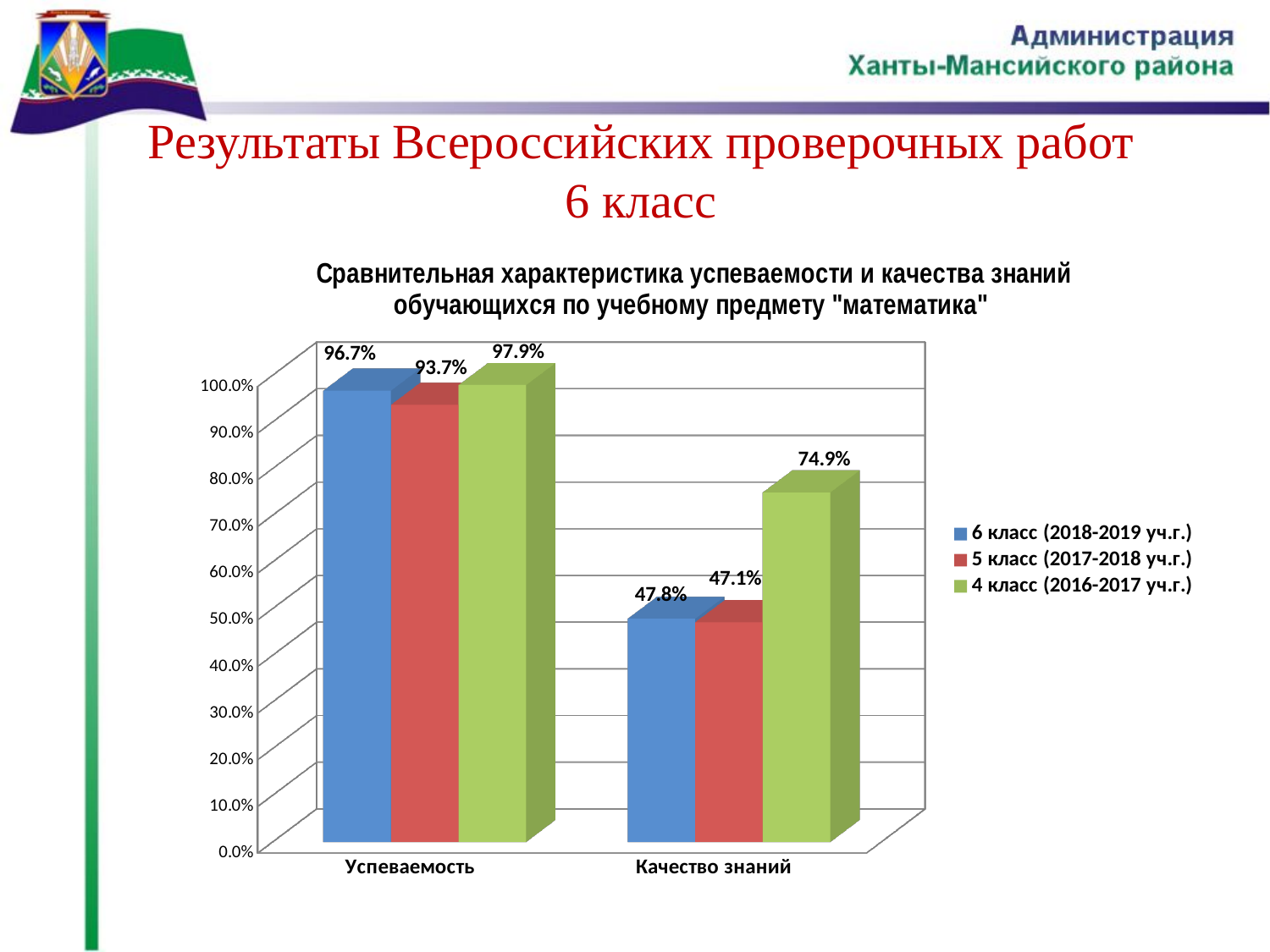
How many categories are shown on the x axis? 2 Is the value for 6 класс (2018-2019 уч.г.) in the Качество знаний category greater or less than 50.0%? less What colour represents 4 класс (2016-2017 уч.г.) in the chart? green What is the value for 6 класс (2018-2019 уч.г.) in the Успеваемость category? 96.7% Which is larger in the Успеваемость category: the value for 6 класс (2018-2019 уч.г.) or for 5 класс (2017-2018 уч.г.)? 6 класс (2018-2019 уч.г.) What is the value for 4 класс (2016-2017 уч.г.) in the Качество знаний category? 74.9% What is the value for 5 класс (2017-2018 уч.г.) in the Успеваемость category? 93.7% How many series does the legend list? 3 What kind of chart is shown on the slide? bar chart Which series has the lowest value in the Качество знаний category? 5 класс (2017-2018 уч.г.) What is the difference between the 4 класс (2016-2017 уч.г.) and 6 класс (2018-2019 уч.г.) values in the Качество знаний category? 27.1% Which series has the highest value in the Успеваемость category? 4 класс (2016-2017 уч.г.)